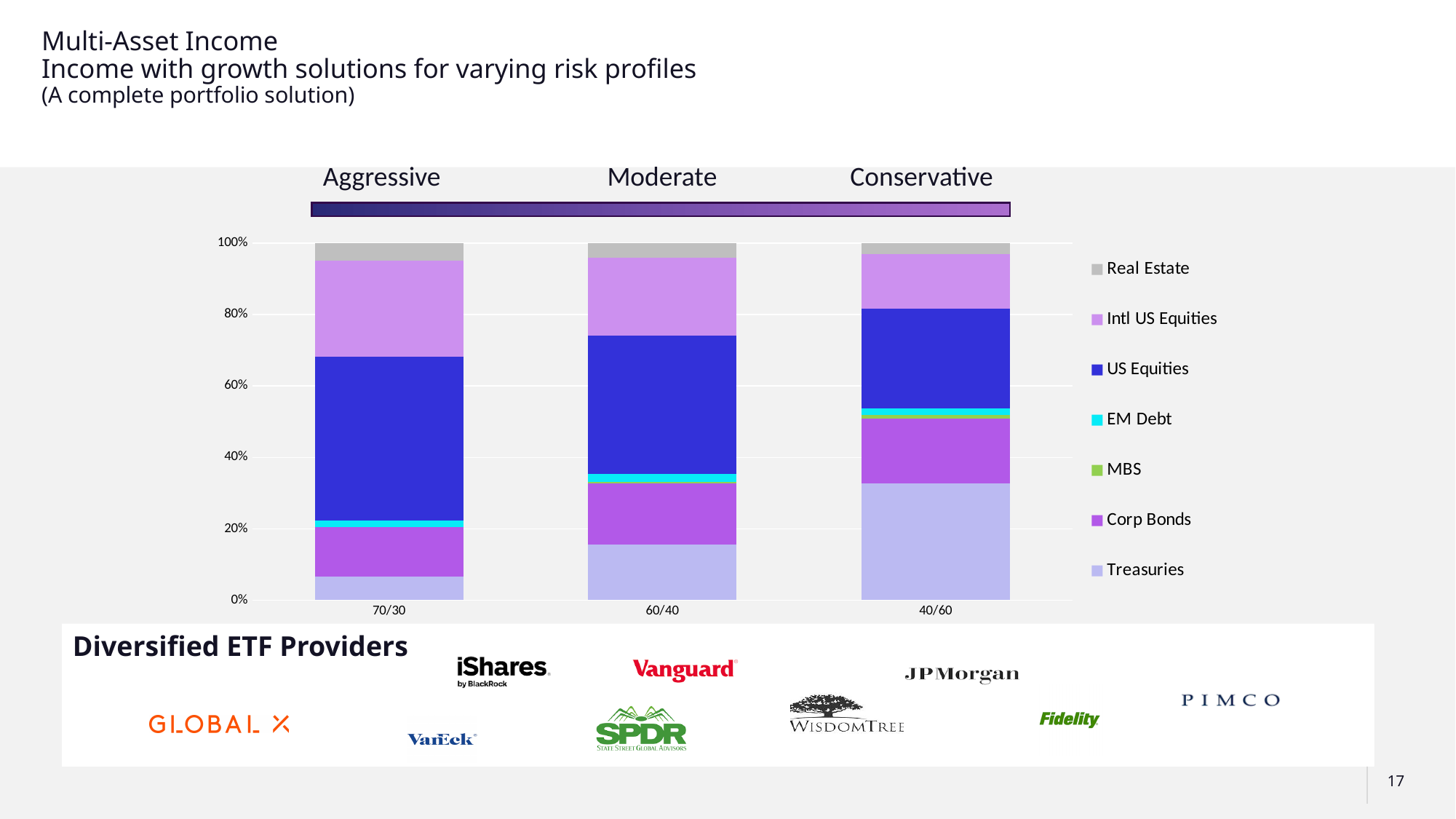
How many bars (portfolio allocations) are plotted on the chart? 3 Is the top of the Treasuries segment in the 70/30 bar greater or less than 20%? less How many series does the chart legend list? 7 Does the Treasuries segment rise or fall moving from the 70/30 bar to the 40/60 bar? rise Which bar has a larger Intl US Equities segment, 70/30 or 40/60? 70/30 Which series forms the largest segment of the 70/30 bar? US Equities Which bar has the largest Treasuries segment? 40/60 Which series is shown in grey at the top of each bar? Real Estate Which bar has a larger US Equities segment, 70/30 or 40/60? 70/30 What kind of chart is shown on the slide? Stacked bar chart Which risk profile label appears above the 70/30 bar? Aggressive Is the top of the Treasuries segment in the 40/60 bar greater or less than 20%? greater